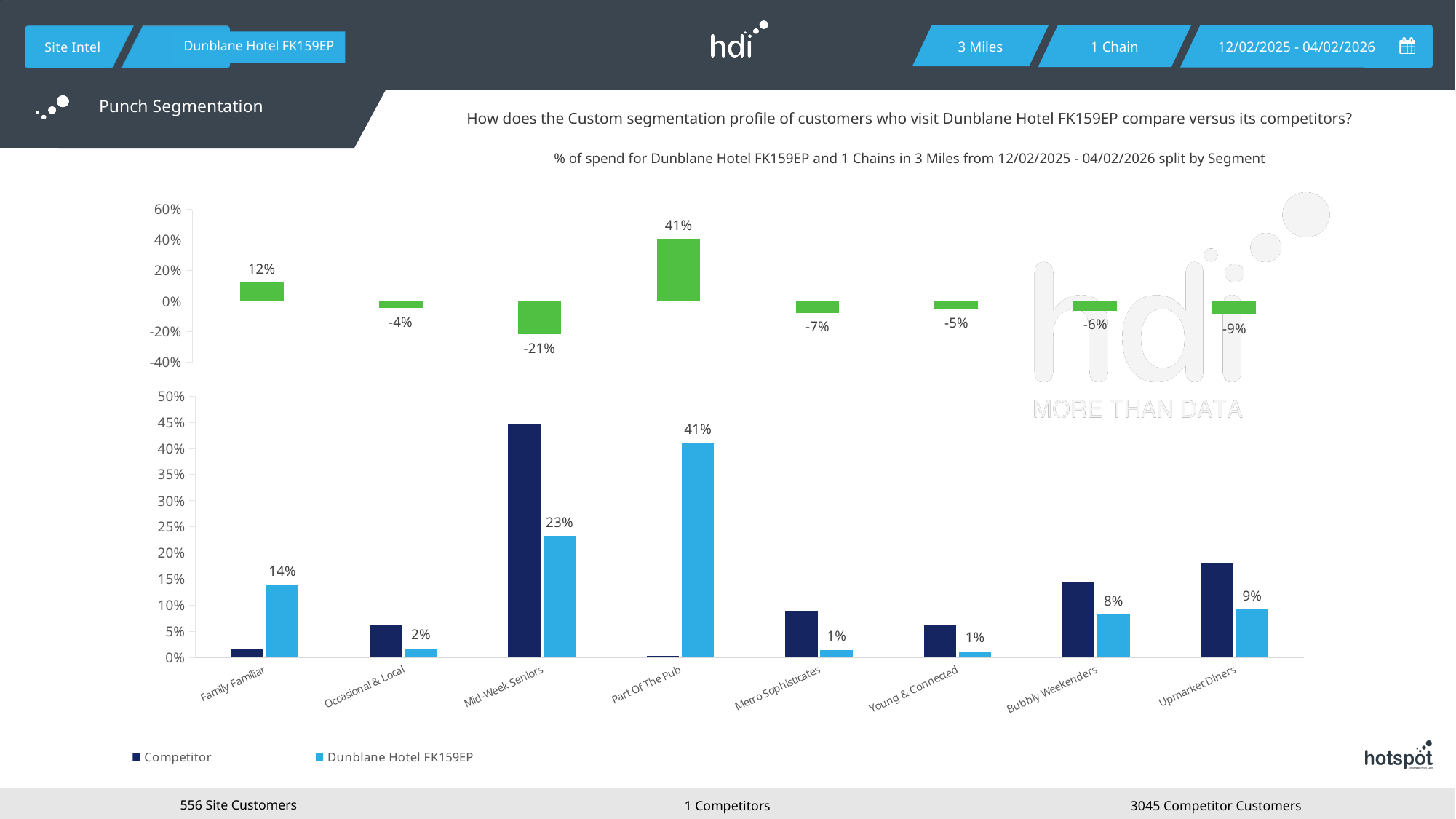
In the top chart, which segment has the highest value? Part Of The Pub In the bottom chart, for Family Familiar, which series has the larger value: Competitor or Dunblane Hotel FK159EP? Dunblane Hotel FK159EP In the bottom chart, what is the value for Dunblane Hotel FK159EP in the Bubbly Weekenders segment? 8% In the bottom chart, is the Competitor value for Mid-Week Seniors greater or less than 40%? greater What kind of chart is the bottom chart? Bar chart In the bottom chart, what is the value for Dunblane Hotel FK159EP in the Part Of The Pub segment? 41% How many series does the legend of the bottom chart list? 2 In the bottom chart, what is the difference between the Dunblane Hotel FK159EP values for Part Of The Pub and Mid-Week Seniors? 18 percentage points How many segments are shown on the x axis of the bottom chart? 8 In the bottom chart, is the Competitor value for Upmarket Diners greater or less than 15%? greater In the top chart, what is the value shown for Mid-Week Seniors? -21% In the top chart, which segment has the lowest value? Mid-Week Seniors